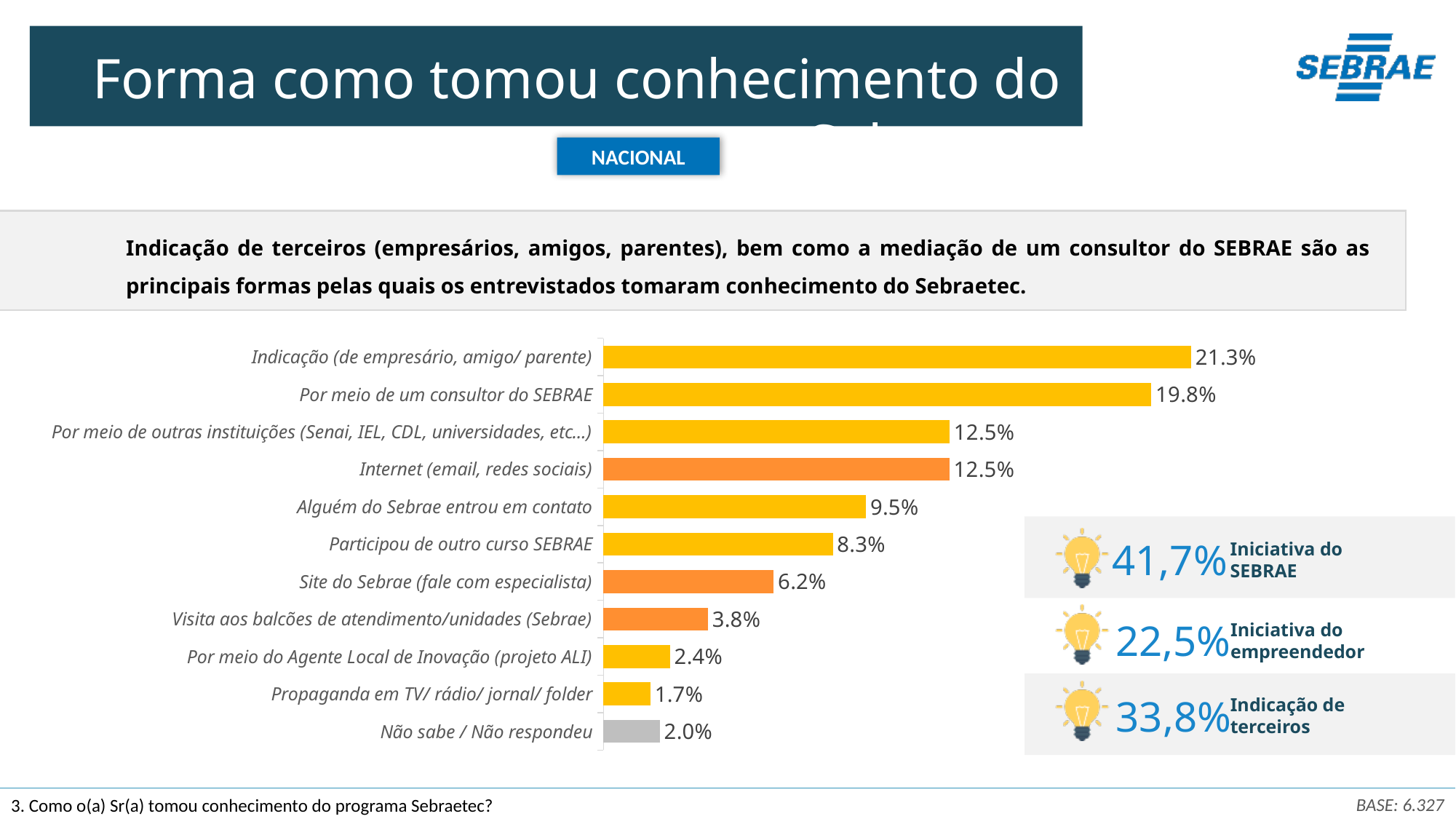
What is the value for 'Propaganda em TV/ rádio/ jornal/ folder'? 1.7% What kind of chart is shown on the slide? Bar chart What is the value for 'Internet (email, redes sociais)'? 12.5% What is the value for 'Site do Sebrae (fale com especialista)'? 6.2% What percentage is shown next to 'Iniciativa do SEBRAE' in the box to the right of the chart? 41,7% What is the difference between 'Indicação (de empresário, amigo/ parente)' and 'Por meio de um consultor do SEBRAE'? 1.5% Which category has the highest value? Indicação (de empresário, amigo/ parente) How many categories are shown in the chart? 11 What is the value for 'Por meio de um consultor do SEBRAE'? 19.8% What is the value for 'Indicação (de empresário, amigo/ parente)'? 21.3% Which is larger: 'Alguém do Sebrae entrou em contato' or 'Participou de outro curso SEBRAE'? Alguém do Sebrae entrou em contato Which category has the lowest value? Propaganda em TV/ rádio/ jornal/ folder